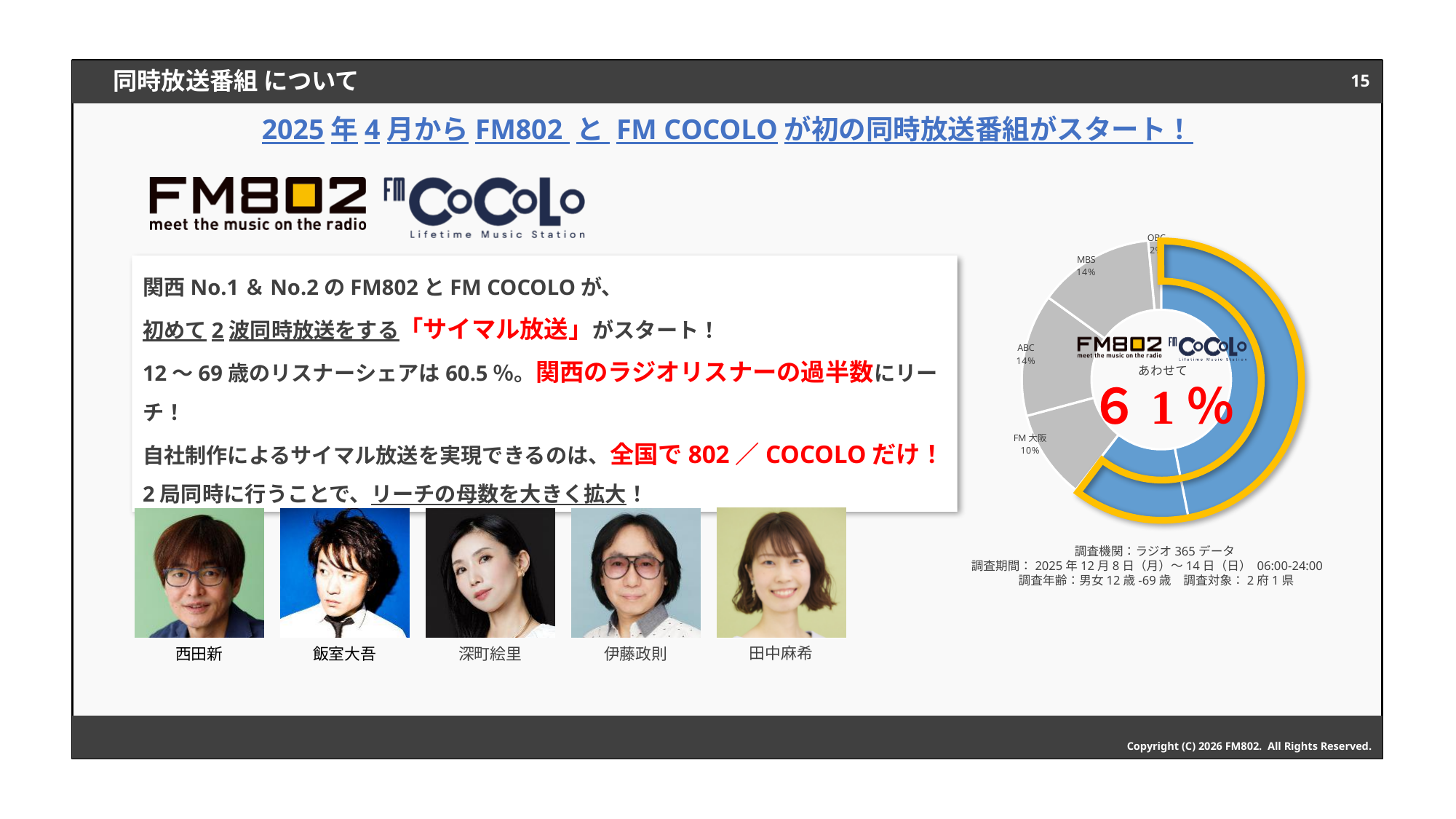
What kind of chart is shown on the right side of the slide? donut (pie) chart What is the listener share shown for MBS in the donut chart? 14% What combined share is shown in the centre of the donut chart for FM802 and FM COCOLO? 61% Which group has the largest share in the donut chart? FM802 and FM COCOLO combined (61%) In the donut chart, what is the difference between the MBS share and the FM大阪 share? 4% What is the listener share shown for FM大阪 in the donut chart? 10% What colour are the FM802 / FM COCOLO segments in the donut chart? blue What word appears above the 61% figure in the centre of the donut chart? あわせて In the donut chart, which has the larger share, ABC or FM大阪? ABC In the donut chart, which has the larger share, MBS or FM大阪? MBS What is the listener share shown for ABC in the donut chart? 14% Is the combined FM802 and FM COCOLO share in the donut chart greater or less than 50%? greater